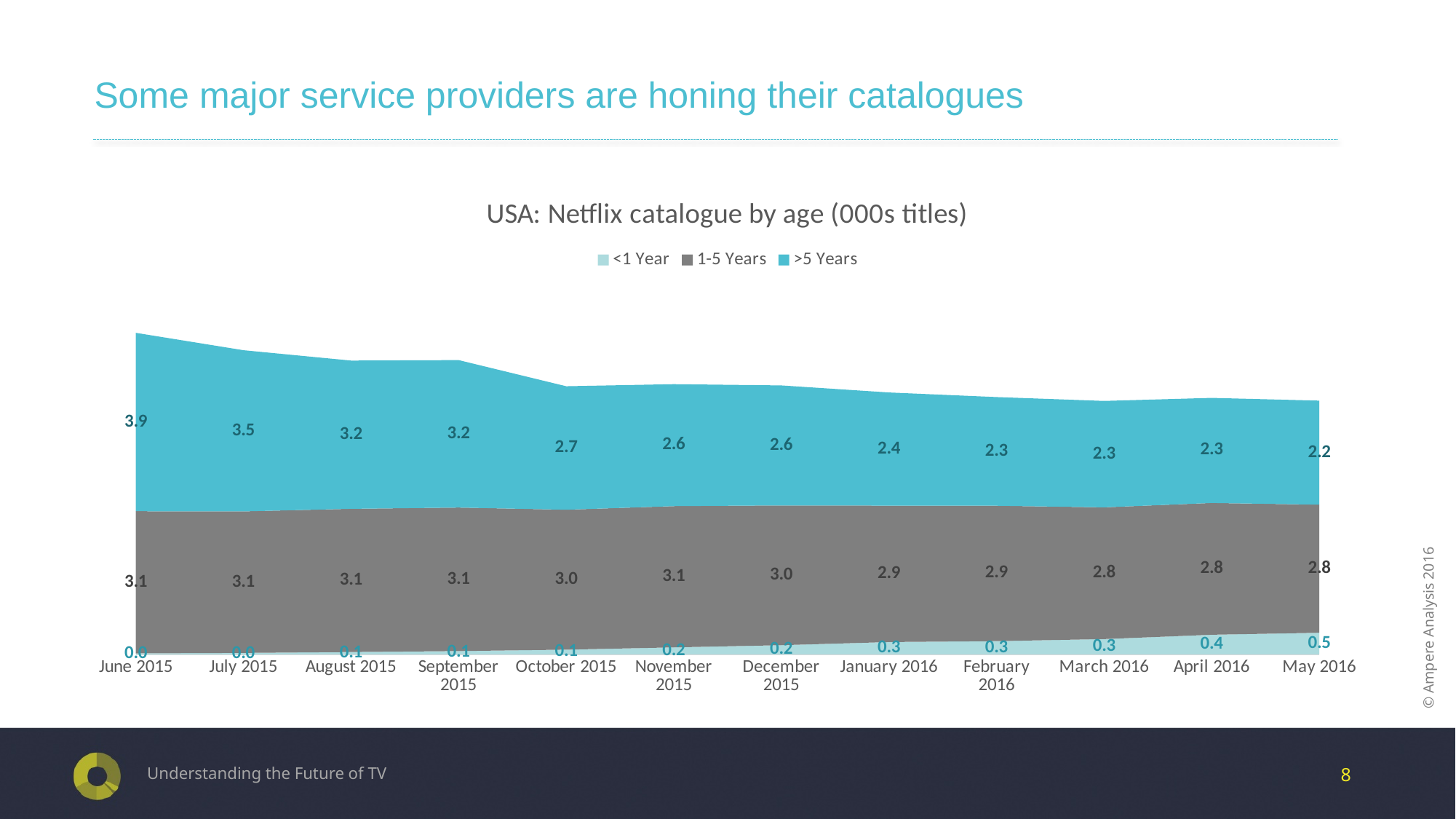
What kind of chart is this? Stacked area chart What is the value for 1-5 Years in May 2016? 2.8 Does the >5 Years value rise or fall from June 2015 to May 2016? Fall What is the total of all three series in May 2016? 5.5 In which month is the >5 Years value highest? June 2015 What is the value for >5 Years in June 2015? 3.9 What is the difference between the >5 Years value in June 2015 and in May 2016? 1.7 Which is larger in October 2015: the 1-5 Years value or the >5 Years value? 1-5 Years In which month is the <1 Year value highest? May 2016 How many series does the legend list? 3 How many months are shown on the x axis? 12 What is the value for <1 Year in April 2016? 0.4